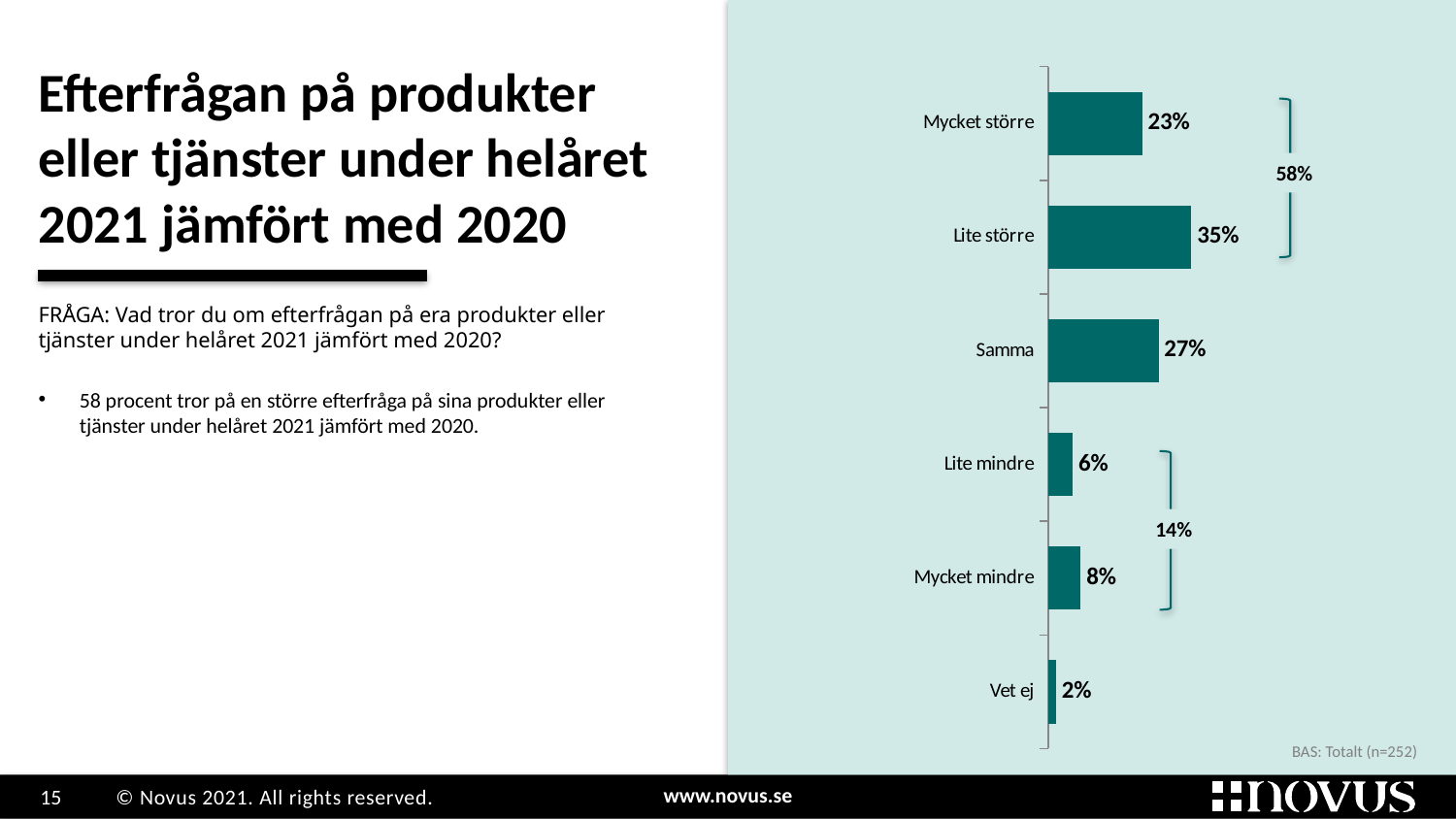
Which category has the highest value? Lite större What base (n) is stated for the chart? Totalt (n=252) What is the value for "Vet ej"? 2% What kind of chart is shown on the slide? Bar chart Which category has the lowest value? Vet ej What is the combined value shown for "Mycket större" and "Lite större" together? 58% What is the value for "Lite större"? 35% What is the difference between "Lite större" and "Mycket större"? 12% How many categories are shown in the chart? 6 What is the value for "Mycket mindre"? 8% Which is larger, "Samma" or "Mycket större"? Samma What is the combined value shown for "Lite mindre" and "Mycket mindre" together? 14%